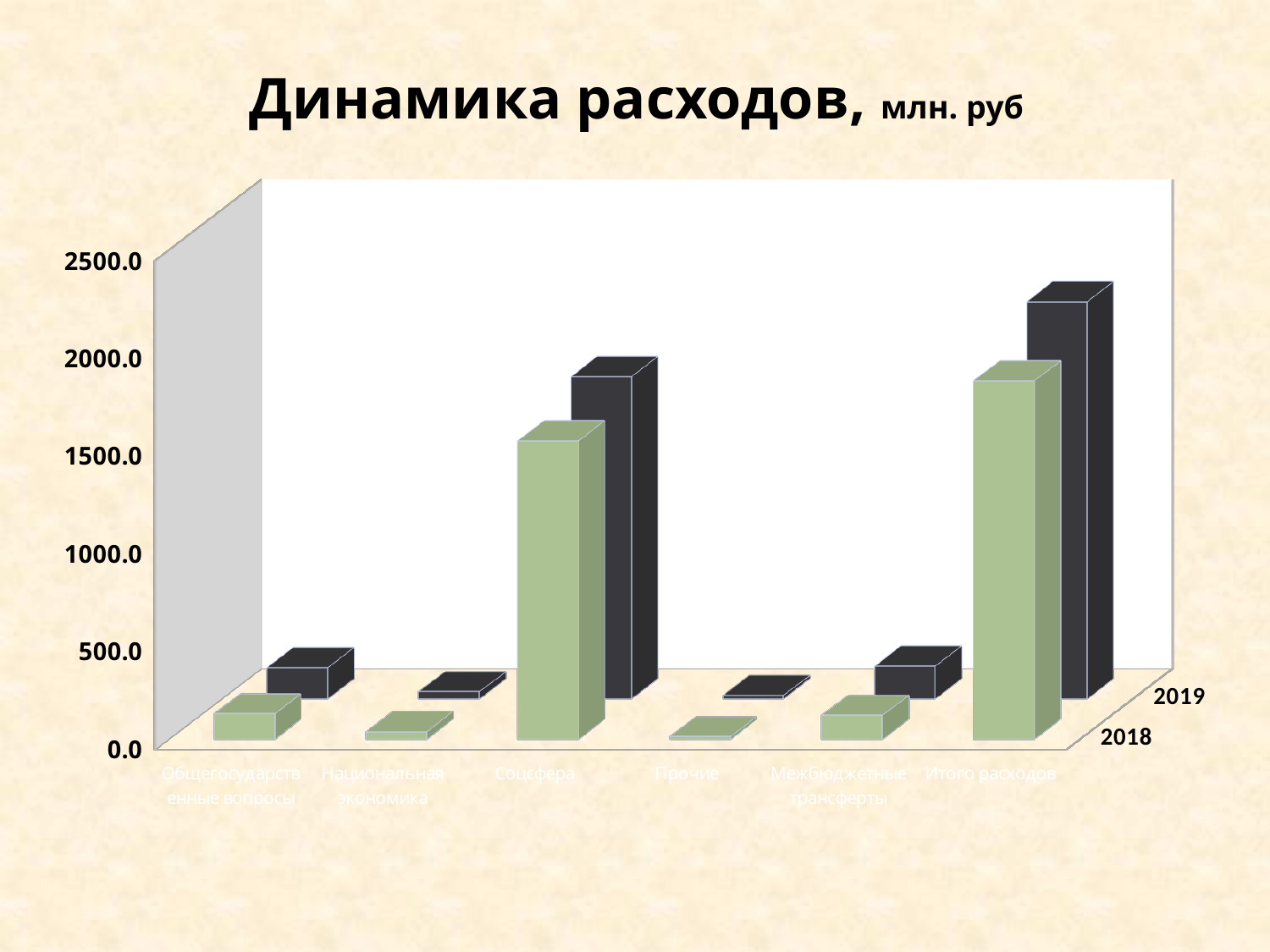
In 2018, which is larger: Соцсфера or Межбюджетные трансферты? Соцсфера Which category has the highest value for 2019? Итого расходов How many series does the chart show? 2 For Соцсфера, which year has the larger value, 2018 or 2019? 2019 What is the title of the chart? Динамика расходов, млн. руб Which two years are plotted in the chart? 2018 and 2019 What kind of chart is shown on the slide? bar chart Is the 2019 value for Общегосударственные вопросы greater or less than 500? less For Итого расходов, which year has the larger value, 2018 or 2019? 2019 How many categories are shown on the x axis of the chart? 6 Which category has the highest value for 2018? Итого расходов